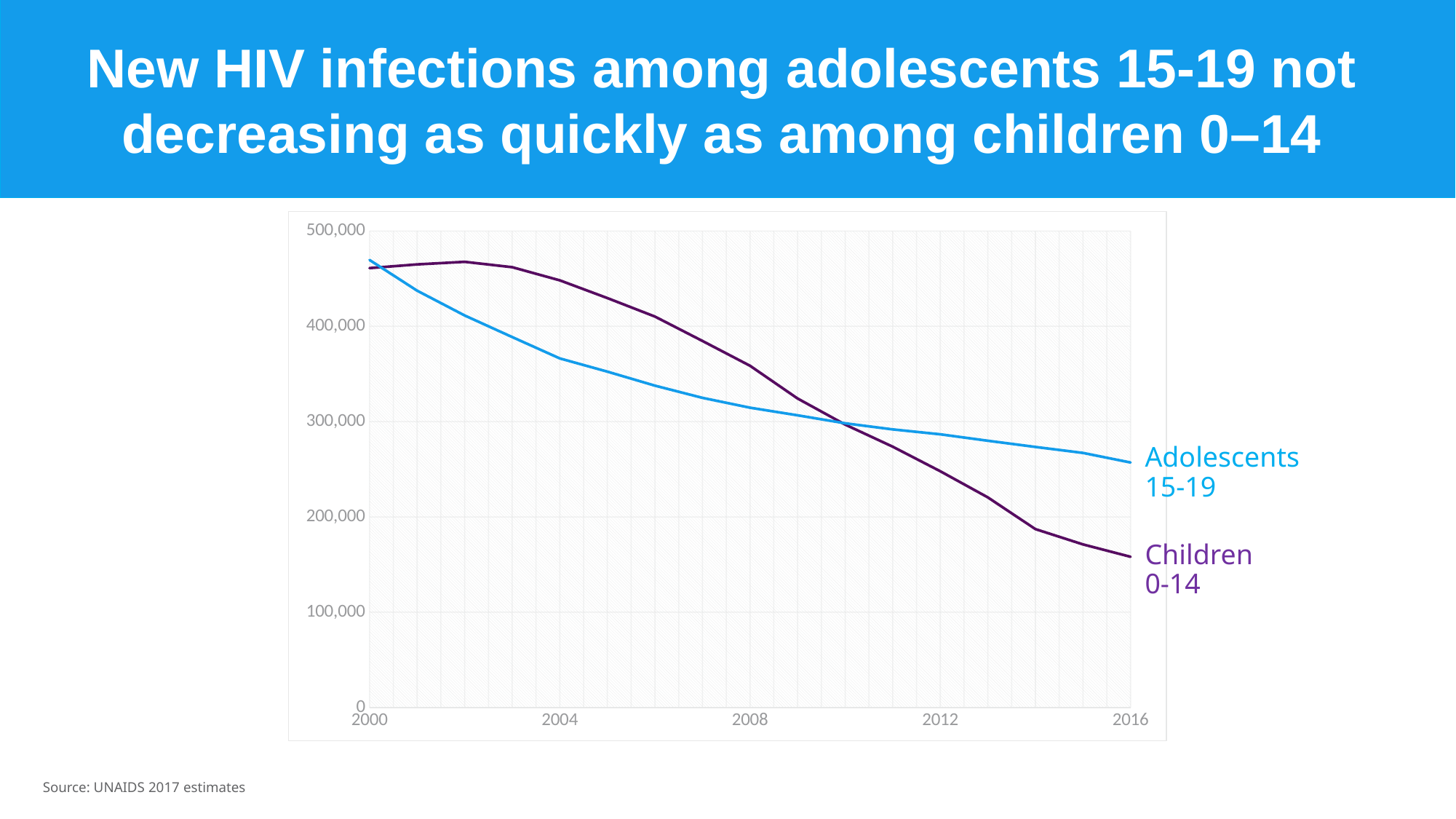
Is the value for Children 0-14 in 2016 greater or less than 200,000? less What kind of chart is shown on the slide? Line chart In 2016, which series has the higher value, Adolescents 15-19 or Children 0-14? Adolescents 15-19 Does the Children 0-14 line rise or fall from 2004 to 2016? Fall How many series are plotted on the chart? 2 Is the value for Children 0-14 in 2000 greater or less than 400,000? greater Is the value for Adolescents 15-19 in 2004 greater or less than 400,000? less In 2004, which series has the higher value, Adolescents 15-19 or Children 0-14? Children 0-14 Does the Adolescents 15-19 line rise or fall from 2000 to 2016? Fall Which series is drawn in purple? Children 0-14 What are the two series labelled on the chart? Adolescents 15-19 and Children 0-14